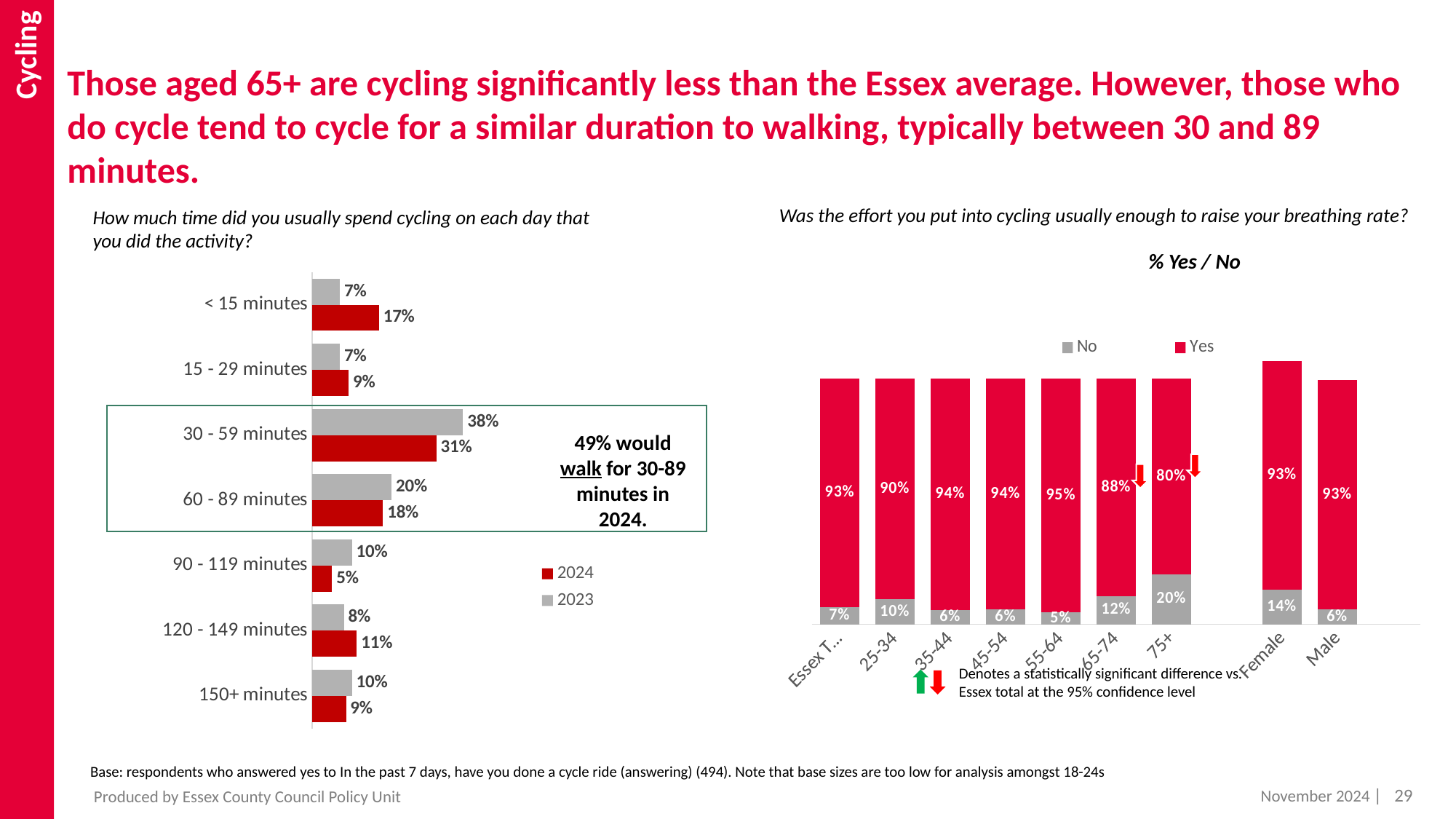
In the chart 'How much time did you usually spend cycling on each day that you did the activity?', how many series does the legend list? 2 What kind of chart is 'Was the effort you put into cycling usually enough to raise your breathing rate?'? Stacked bar chart In the chart 'Was the effort you put into cycling usually enough to raise your breathing rate?', is the No value larger for Female or Male? Female In the chart 'How much time did you usually spend cycling on each day that you did the activity?', which category has the highest 2024 value? 30 - 59 minutes In the chart 'How much time did you usually spend cycling on each day that you did the activity?', what is the 2024 value for '30 - 59 minutes'? 31% In the chart 'Was the effort you put into cycling usually enough to raise your breathing rate?', which age group has the highest Yes value? 55-64 In the chart 'Was the effort you put into cycling usually enough to raise your breathing rate?', what is the total of the stacked bar for 65-74? 100% In the chart 'How much time did you usually spend cycling on each day that you did the activity?', how many time categories are shown? 7 In the chart 'How much time did you usually spend cycling on each day that you did the activity?', what is the 2023 value for '< 15 minutes'? 7% In the chart 'How much time did you usually spend cycling on each day that you did the activity?', which category has the lowest 2024 value? 90 - 119 minutes In the chart 'Was the effort you put into cycling usually enough to raise your breathing rate?', what is the Yes value for 75+? 80% In the chart 'How much time did you usually spend cycling on each day that you did the activity?', what is the difference between the 2023 and 2024 values for '< 15 minutes'? 10%